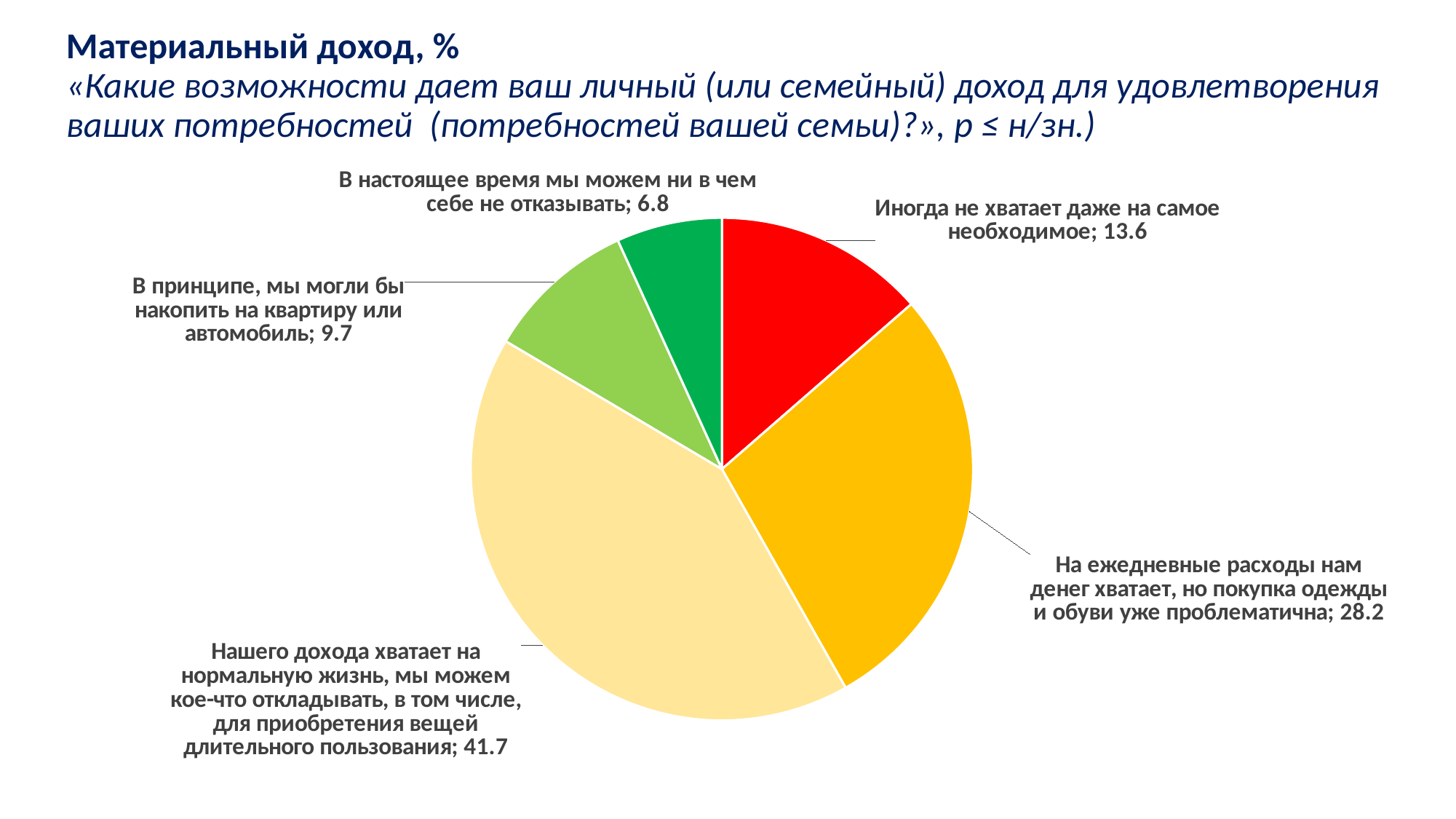
How many slices does the pie chart have? 5 What kind of chart is shown on the slide? Pie chart Which category has the smallest slice of the pie? В настоящее время мы можем ни в чем себе не отказывать What is the value for «В настоящее время мы можем ни в чем себе не отказывать»? 6.8 What is the value for «Иногда не хватает даже на самое необходимое»? 13.6 Which is larger: the value for «Иногда не хватает даже на самое необходимое» or for «В принципе, мы могли бы накопить на квартиру или автомобиль»? Иногда не хватает даже на самое необходимое Which category has the largest slice of the pie? Нашего дохода хватает на нормальную жизнь, мы можем кое-что откладывать, в том числе, для приобретения вещей длительного пользования What is the value for «В принципе, мы могли бы накопить на квартиру или автомобиль»? 9.7 What colour is the slice for «Иногда не хватает даже на самое необходимое»? Red What is the value for «На ежедневные расходы нам денег хватает, но покупка одежды и обуви уже проблематична»? 28.2 What is the difference between the value for «Нашего дохода хватает на нормальную жизнь...» (41.7) and «На ежедневные расходы нам денег хватает...» (28.2)? 13.5 What is the difference between the value for «Иногда не хватает даже на самое необходимое» and «В настоящее время мы можем ни в чем себе не отказывать»? 6.8